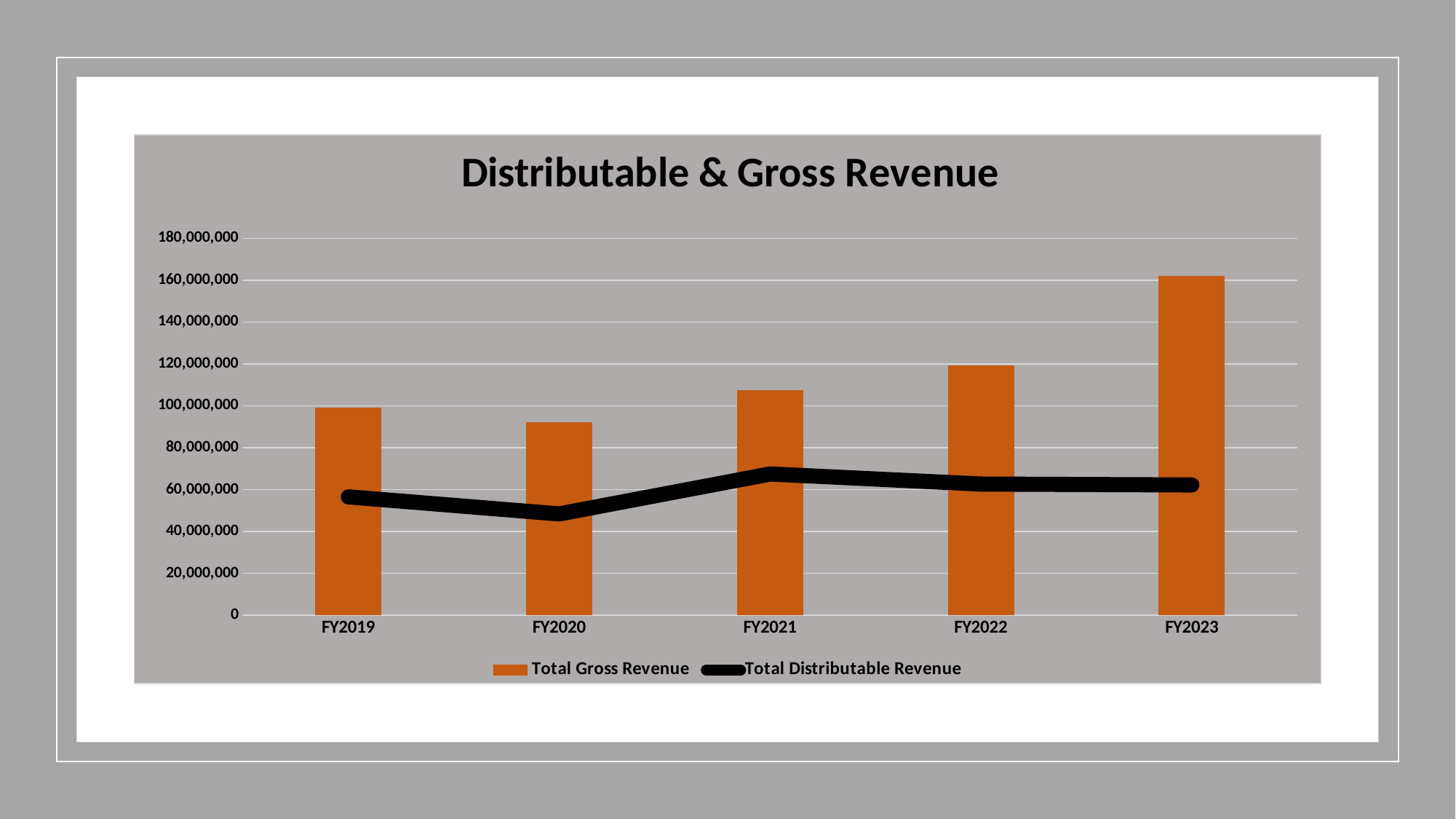
Is the Total Gross Revenue for FY2023 greater or less than 140,000,000? greater Which is larger, the Total Gross Revenue for FY2019 or for FY2023? FY2023 Which fiscal year has the highest Total Distributable Revenue? FY2021 How many fiscal years are shown on the x axis? 5 Which fiscal year has the lowest Total Gross Revenue? FY2020 Is the Total Distributable Revenue for FY2021 greater or less than 60,000,000? greater How many series does the legend list? 2 Which fiscal year has the highest Total Gross Revenue? FY2023 Which fiscal year has the lowest Total Distributable Revenue? FY2020 Does Total Gross Revenue rise or fall from FY2020 to FY2023? rise Is the Total Gross Revenue for FY2020 greater or less than 100,000,000? less